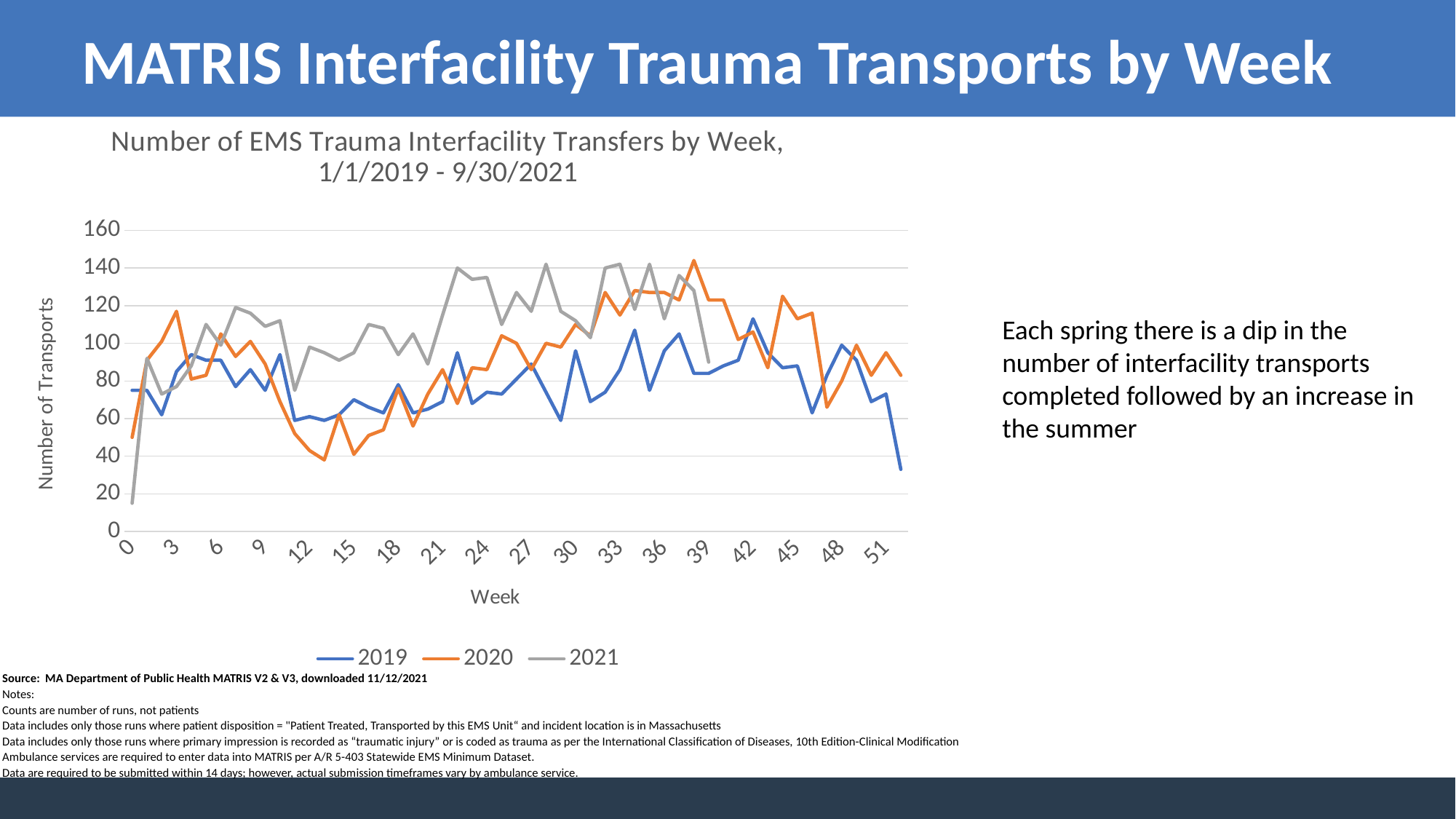
Is the value for the 2020 series at week 13 greater or less than 60? less What kind of chart is shown on the slide? line chart At week 0, which series has the larger value, 2019 or 2021? 2019 Is the value for the 2021 series at week 0 greater or less than 20? less Is the value for the 2019 series at week 35 greater or less than 100? less What are the series names listed in the legend? 2019, 2020, 2021 What is the label on the vertical axis? Number of Transports Does the 2020 series rise or fall between week 3 and week 13? fall At week 24, which series has the larger value, 2019 or 2021? 2021 How many series does the legend list? 3